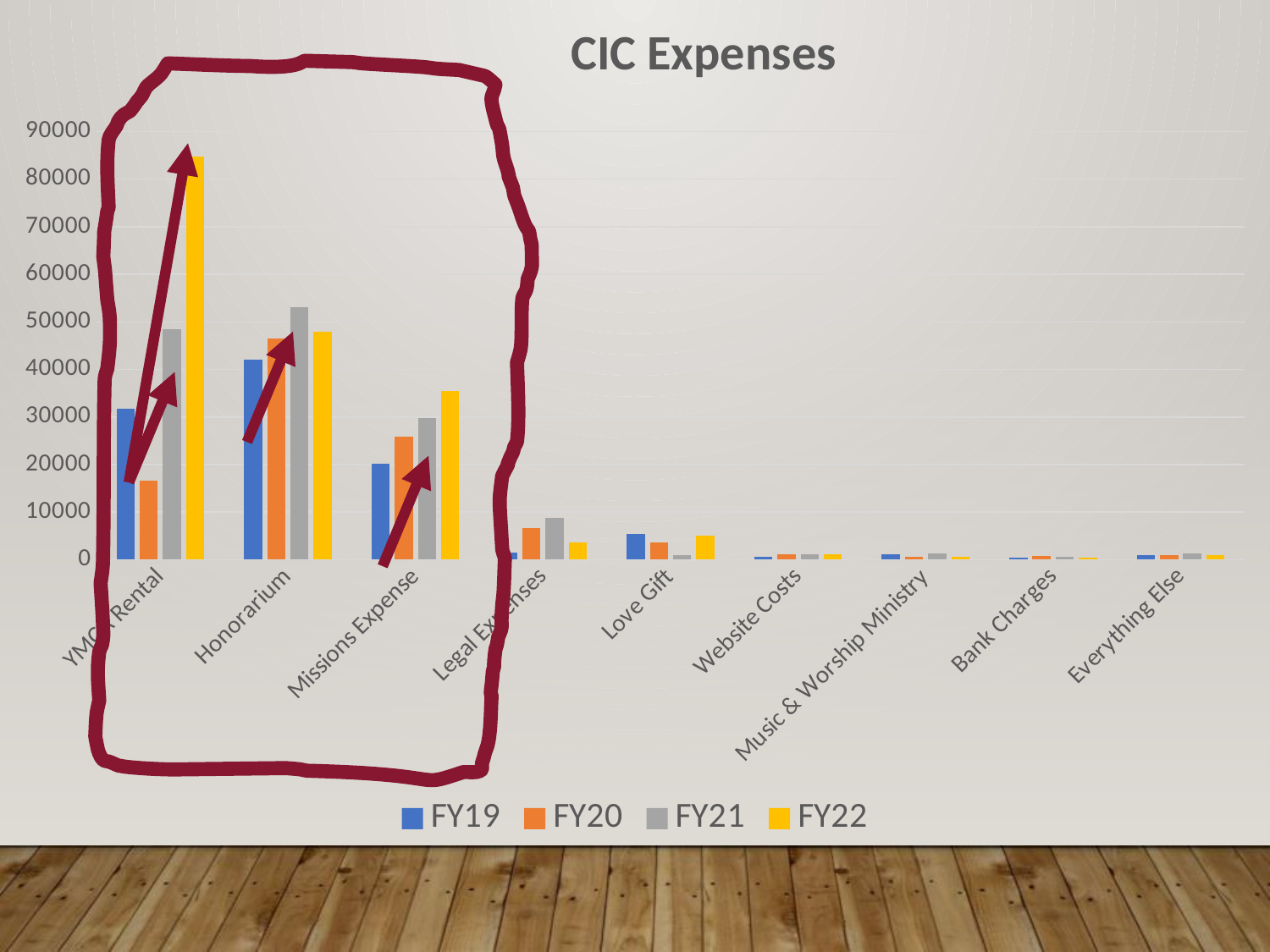
Is the FY21 value for Honorarium greater or less than 50000? greater For Honorarium, which is larger: the FY21 value or the FY22 value? FY21 How many expense categories are shown on the x axis? 9 How many series does the legend list? 4 Which category has the highest FY22 value? YMCA Rental What type of chart is shown on the slide? Bar chart Do the Missions Expense values rise or fall from FY19 to FY22? Rise Is the FY22 value for YMCA Rental greater or less than 80000? greater Which series has the highest value for YMCA Rental? FY22 Which fiscal years are listed in the legend? FY19, FY20, FY21, FY22 Is the FY22 value for Missions Expense greater or less than 30000? greater What is the title of the chart? CIC Expenses